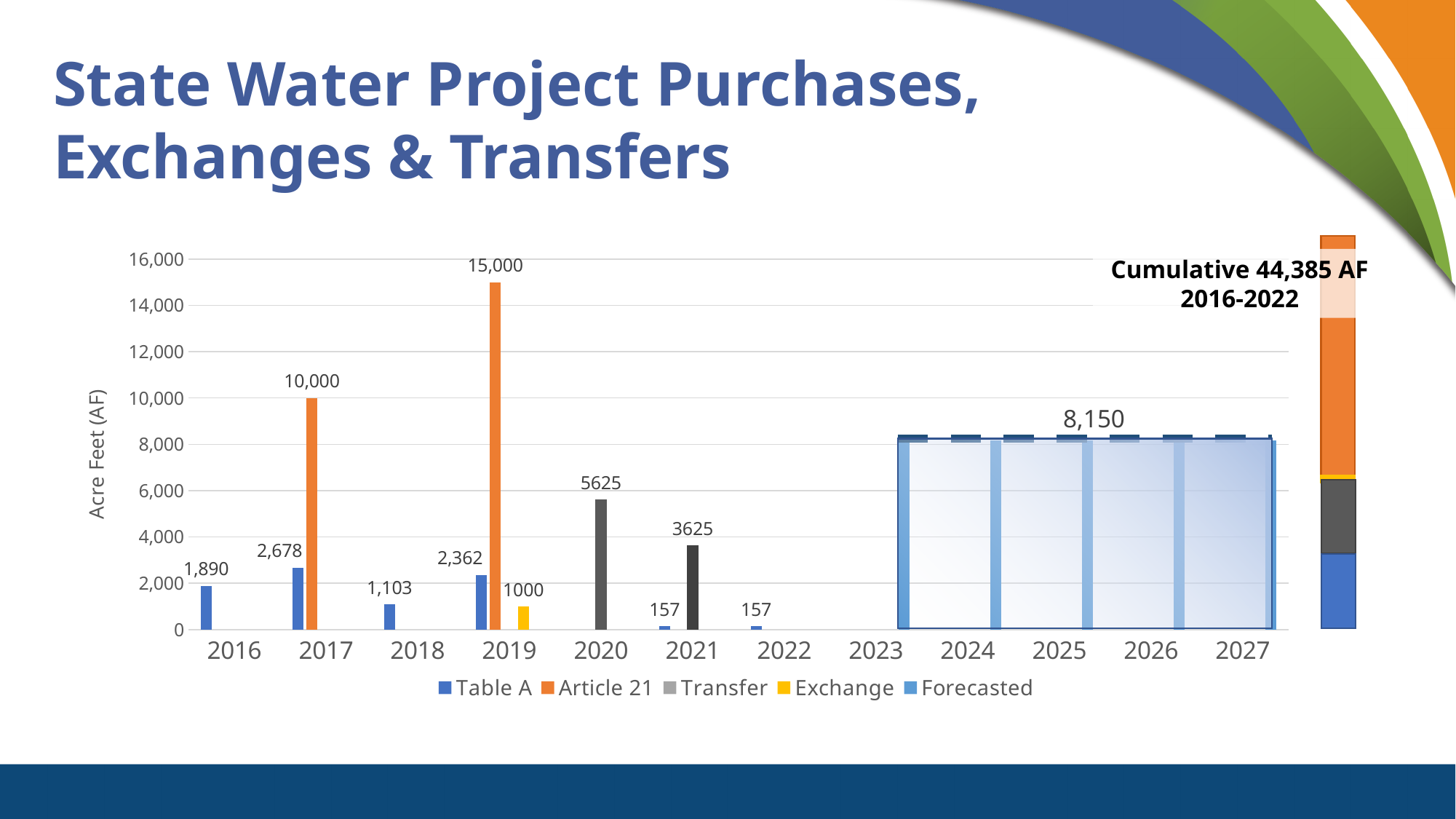
How many series does the legend list? 5 Among 2016, 2017, 2018 and 2019, which year has the lowest Table A value? 2018 What is the Exchange value for 2019? 1000 What cumulative total for 2016-2022 is stated on the slide? 44,385 AF What is the Transfer value for 2020? 5625 In which year is the Article 21 value highest? 2019 What is the Article 21 value for 2019? 15,000 What is the difference between the Article 21 values for 2019 and 2017? 5,000 What kind of chart is shown on the slide? Bar chart What is the Table A value for 2016? 1,890 Which year has the larger Transfer value, 2020 or 2021? 2020 What is the Article 21 value for 2017? 10,000